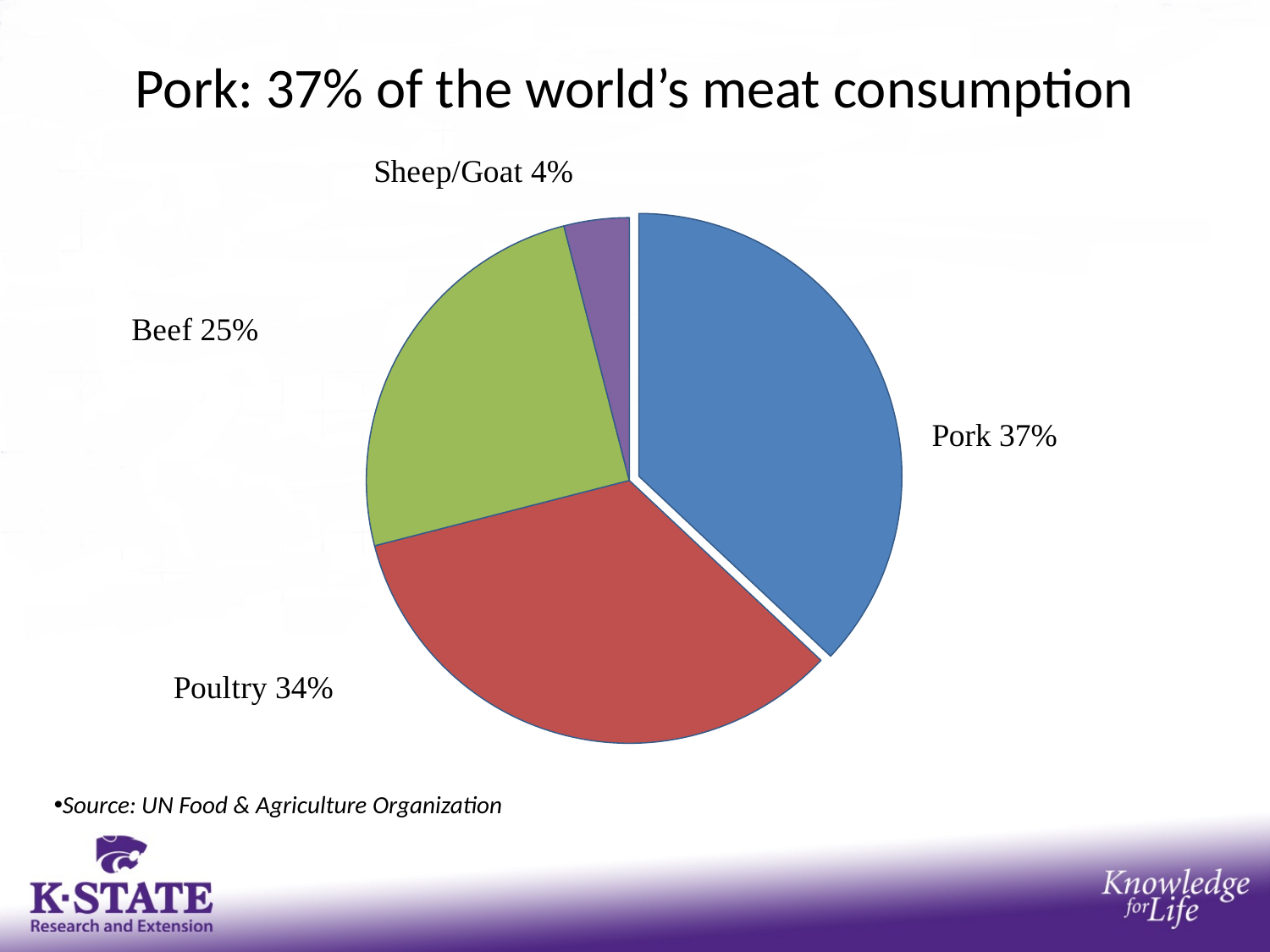
What share of the pie is Poultry? 34% Which category has the largest slice of the pie? Pork What is the title of the slide? Pork: 37% of the world's meat consumption What kind of chart is shown on the slide? Pie chart How many categories are shown in the pie chart? 4 What share of the pie is Beef? 25% Which is larger, the share for Poultry or the share for Beef? Poultry What is the difference in percentage points between Beef and Sheep/Goat? 21 Which category has the smallest slice of the pie? Sheep/Goat What share of the pie is Sheep/Goat? 4% What is the difference in percentage points between Pork and Poultry? 3